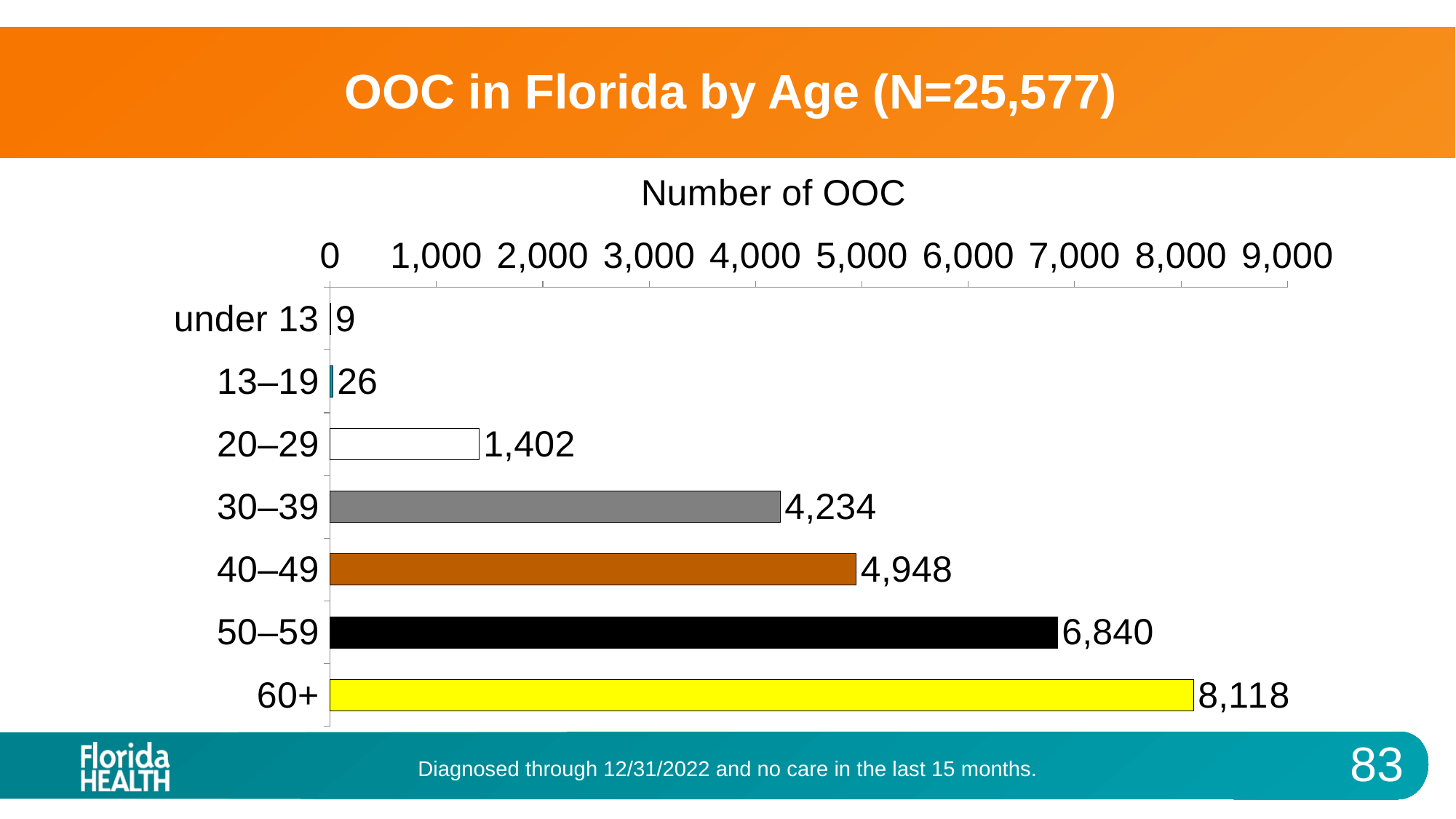
What is the number of OOC for the under 13 age group? 9 What colour is the bar for the 60+ age group? yellow Which age group has more OOC, 20–29 or 30–39? 30–39 Which age group has the highest number of OOC? 60+ Which age group has the lowest number of OOC? under 13 What is the number of OOC for the 30–39 age group? 4,234 Is the number of OOC for the 50–59 age group greater or less than 6,000? greater How many age groups are shown in the chart? 7 What is the difference in number of OOC between the 50–59 and 40–49 age groups? 1,892 What is the number of OOC for the 60+ age group? 8,118 What kind of chart is shown on the slide? bar chart What is the title of the chart? OOC in Florida by Age (N=25,577)